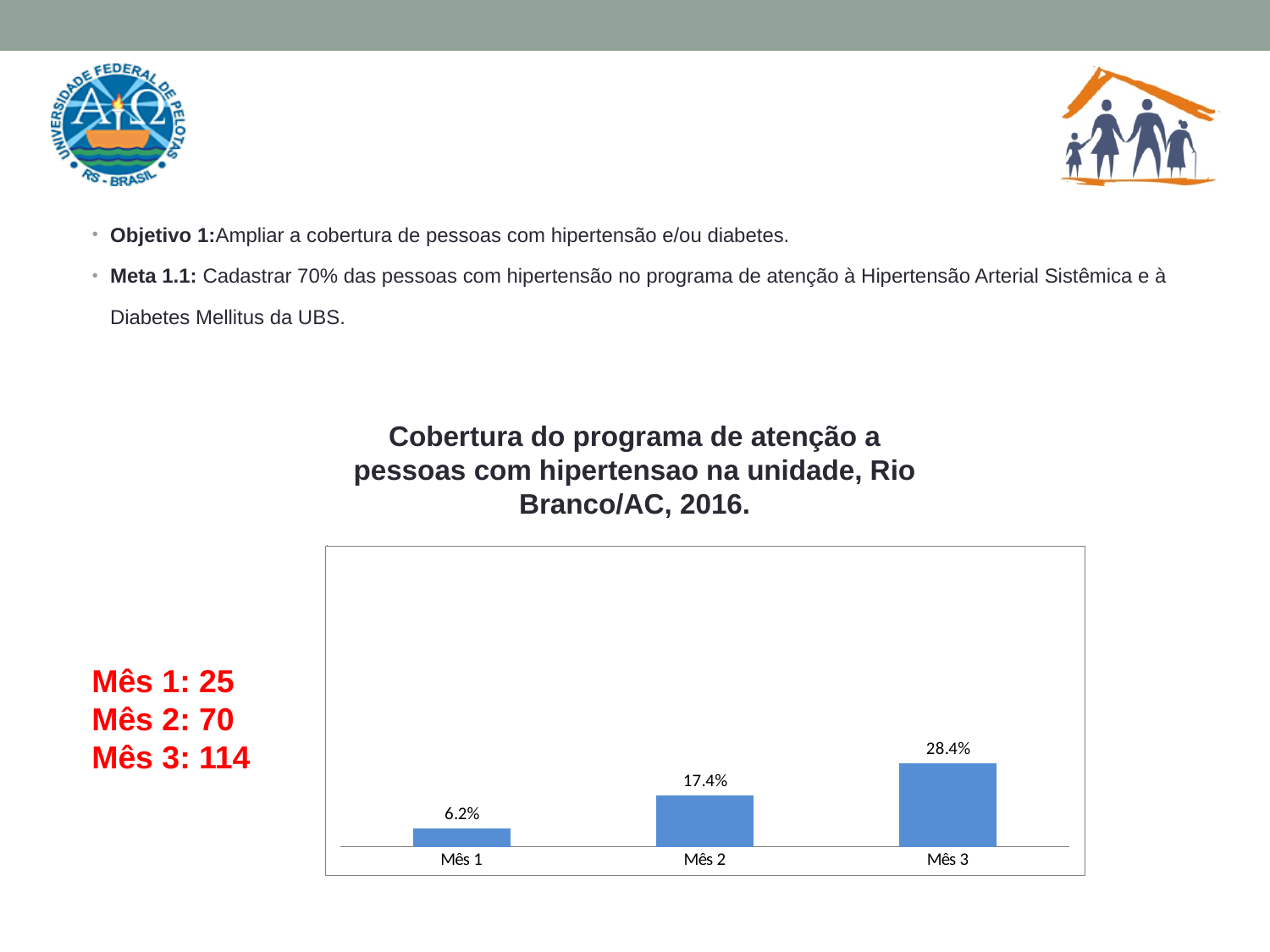
Which month has the lowest coverage value? Mês 1 How many categories are shown on the x axis of the chart? 3 What is the difference between the values for Mês 3 and Mês 2? 11.0% Do the values rise or fall from Mês 1 to Mês 3? Rise What is the value for Mês 3? 28.4% Which is larger, the value for Mês 1 or the value for Mês 2? Mês 2 What is the value for Mês 2? 17.4% What is the value for Mês 1? 6.2% Which month has the highest coverage value? Mês 3 What is the title of the chart? Cobertura do programa de atenção a pessoas com hipertensao na unidade, Rio Branco/AC, 2016. What kind of chart is shown on the slide? Bar chart What is the difference between the values for Mês 2 and Mês 1? 11.2%